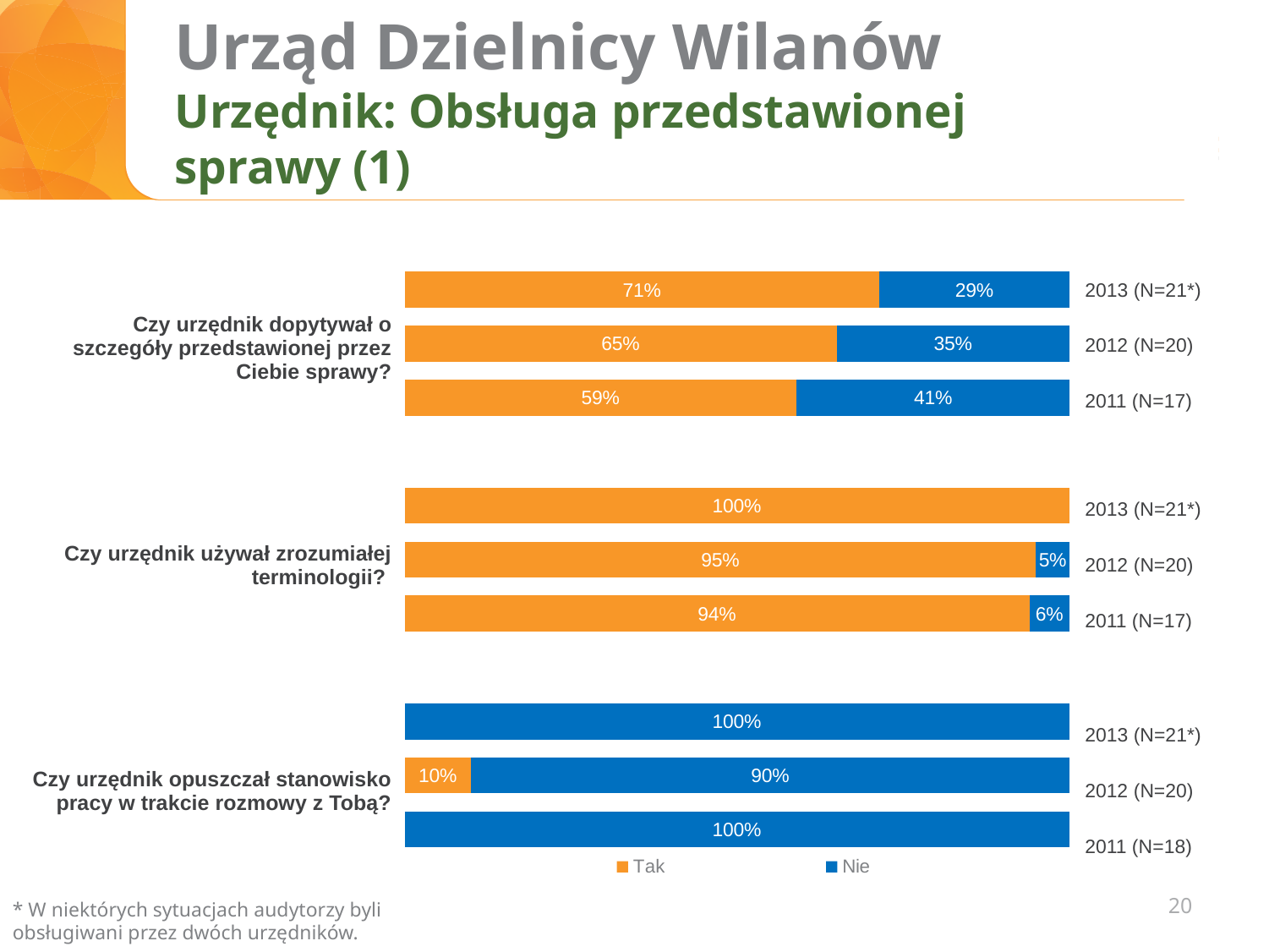
How many series does the legend list? 2 What is the 'Tak' value for 2012 (N=20) for the question 'Czy urzędnik opuszczał stanowisko pracy w trakcie rozmowy z Tobą?'? 10% What is the 'Nie' value for 2011 (N=17) for the question 'Czy urzędnik dopytywał o szczegóły przedstawionej przez Ciebie sprawy?'? 41% How many bars are plotted on the chart in total? 9 What is the 'Tak' value for 2013 (N=21*) for the question 'Czy urzędnik dopytywał o szczegóły przedstawionej przez Ciebie sprawy?'? 71% What is the 'Nie' value for 2012 (N=20) for the question 'Czy urzędnik używał zrozumiałej terminologii?'? 5% For the question 'Czy urzędnik dopytywał o szczegóły przedstawionej przez Ciebie sprawy?', which year has the highest 'Tak' value? 2013 (N=21*) What kind of chart is shown on the slide? stacked bar chart For the question 'Czy urzędnik używał zrozumiałej terminologii?', which year has the lowest 'Tak' value? 2011 (N=17) For the question 'Czy urzędnik dopytywał o szczegóły przedstawionej przez Ciebie sprawy?', what is the difference between the 'Tak' values for 2013 (N=21*) and 2011 (N=17)? 12 percentage points What are the two series named in the legend? Tak and Nie For the question 'Czy urzędnik dopytywał o szczegóły przedstawionej przez Ciebie sprawy?', is the 'Nie' value larger in 2012 (N=20) or in 2011 (N=17)? 2011 (N=17)